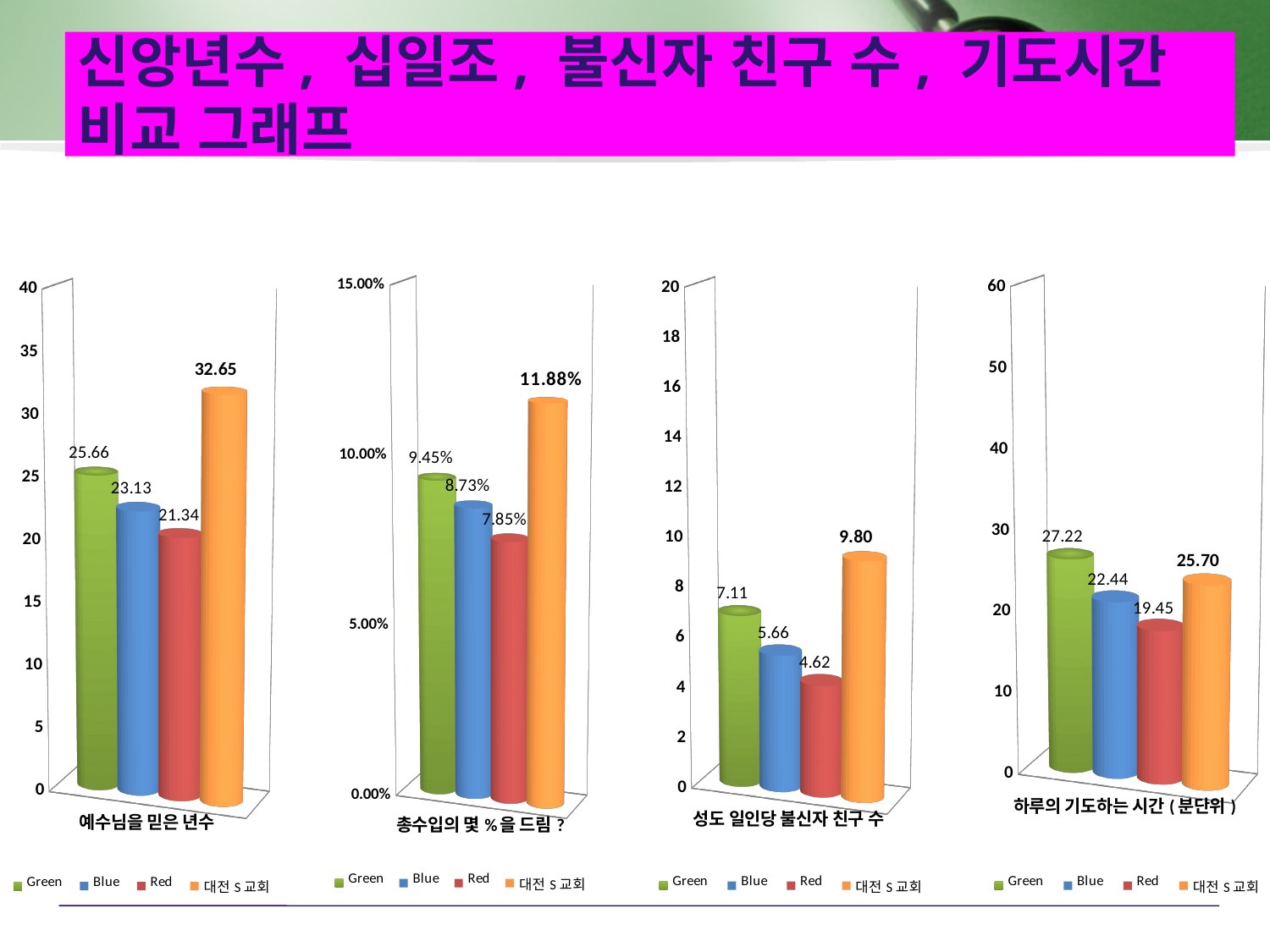
In the chart titled '하루의 기도하는 시간 (분단위)', what is the value for Red? 19.45 In the chart titled '총수입의 몇 %을 드림?', what is the difference between the 대전 S 교회 value and the Red value? 4.03% In the chart titled '성도 일인당 불신자 친구 수', what is the value for Blue? 5.66 In the chart titled '성도 일인당 불신자 친구 수', is the value for 대전 S 교회 greater or less than 8? greater In the chart titled '하루의 기도하는 시간 (분단위)', which series has the highest value? Green How many series does the legend list for the chart titled '예수님을 믿은 년수'? 4 In the chart titled '성도 일인당 불신자 친구 수', which is larger, the Green value or the Red value? Green What kind of chart is the chart titled '하루의 기도하는 시간 (분단위)'? Bar chart In the chart titled '총수입의 몇 %을 드림?', which series has the highest value? 대전 S 교회 In the chart titled '총수입의 몇 %을 드림?', what is the value for Green? 9.45% In the chart titled '예수님을 믿은 년수', what is the value for 대전 S 교회? 32.65 In the chart titled '예수님을 믿은 년수', which series has the lowest value? Red